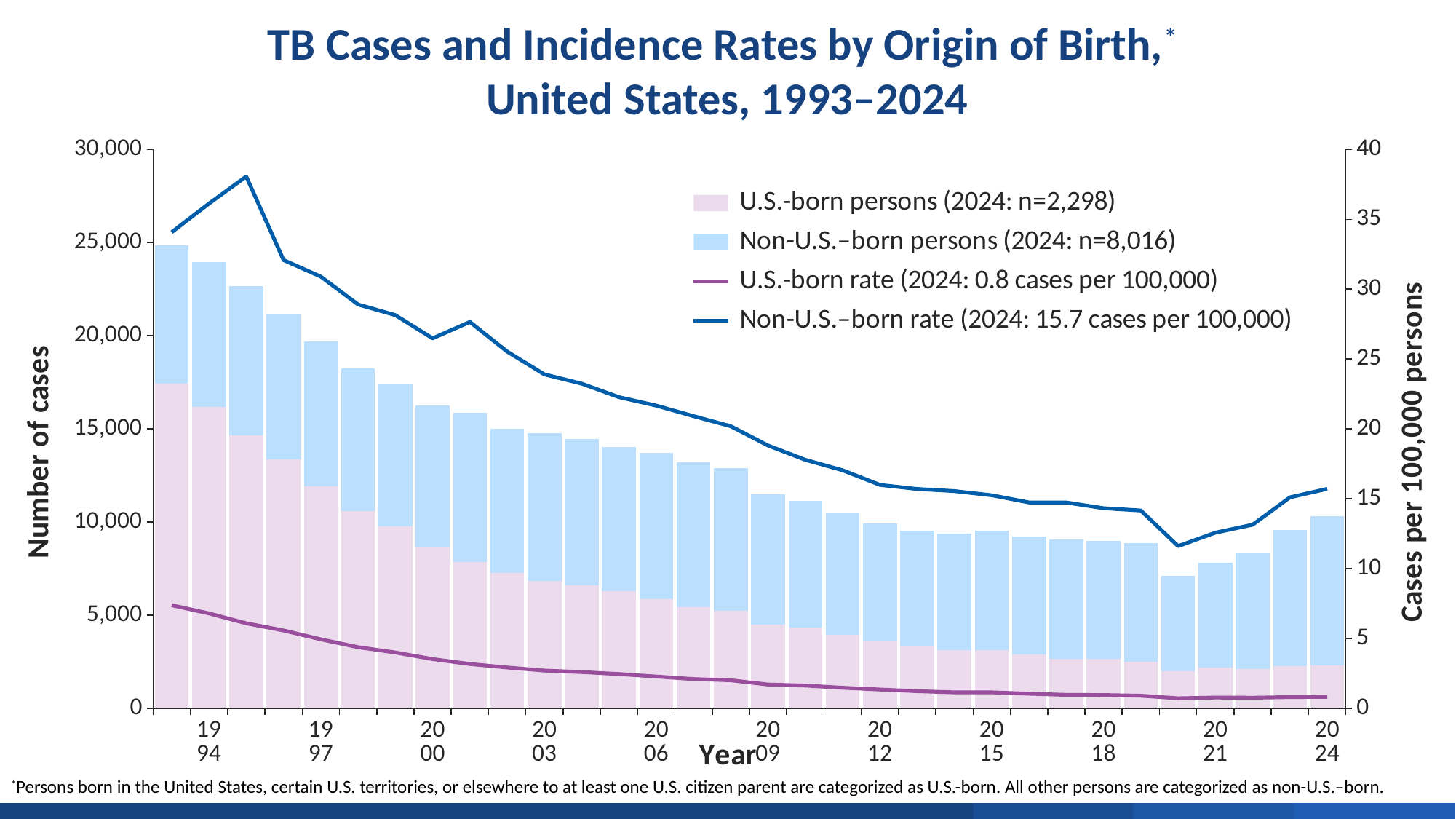
What is the number of TB cases among non-U.S.-born persons in 2024, as given in the legend? 8,016 Is the non-U.S.-born TB rate in 1995 greater or less than 35 cases per 100,000? greater What is the 2024 TB incidence rate for non-U.S.-born persons? 15.7 cases per 100,000 Which year has the highest total number of TB cases? 1993 How many more TB cases were there among non-U.S.-born persons than U.S.-born persons in 2024? 5,718 What is the number of TB cases among U.S.-born persons in 2024, as given in the legend? 2,298 In 2024, which group had more TB cases: U.S.-born persons or non-U.S.-born persons? Non-U.S.-born persons How many series does the legend list? 4 How does the U.S.-born TB rate change from 1993 to 2024? It falls What is the total number of TB cases in 2024 (U.S.-born plus non-U.S.-born)? 10,314 Is the number of TB cases among U.S.-born persons in 1993 greater or less than 15,000? greater What is the 2024 TB incidence rate for U.S.-born persons? 0.8 cases per 100,000